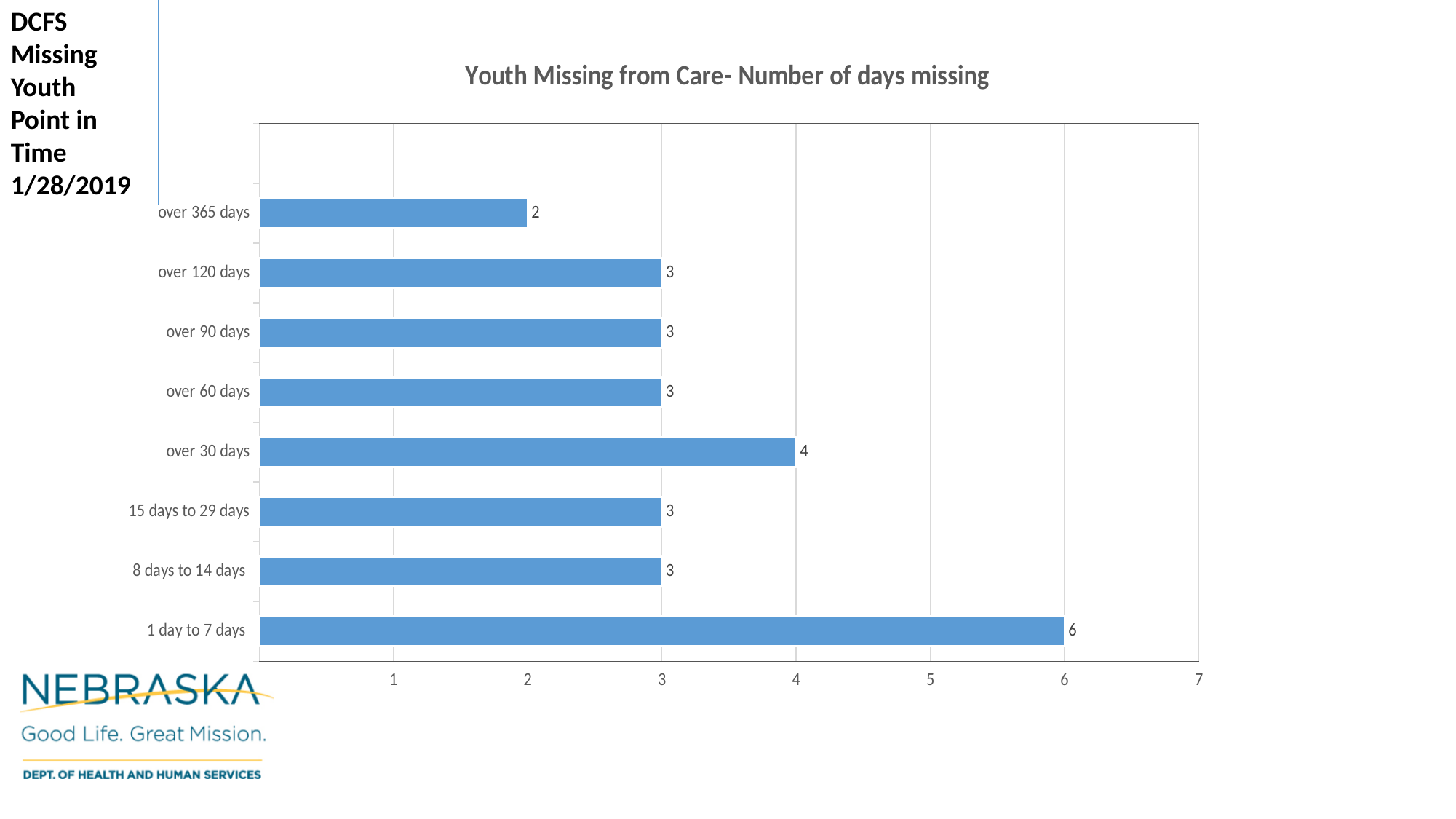
Which category has the lowest value? over 365 days Which category has the highest value? 1 day to 7 days What is the value for 'over 30 days'? 4 What is the value for '8 days to 14 days'? 3 What is the difference between the values for '1 day to 7 days' and 'over 30 days'? 2 What is the value for '1 day to 7 days'? 6 How many categories are shown in the chart? 8 What kind of chart is this? bar chart What is the title of the chart? Youth Missing from Care- Number of days missing What is the highest value shown on the x axis? 7 Which is larger, the value for 'over 30 days' or the value for 'over 365 days'? over 30 days What is the value for 'over 365 days'? 2